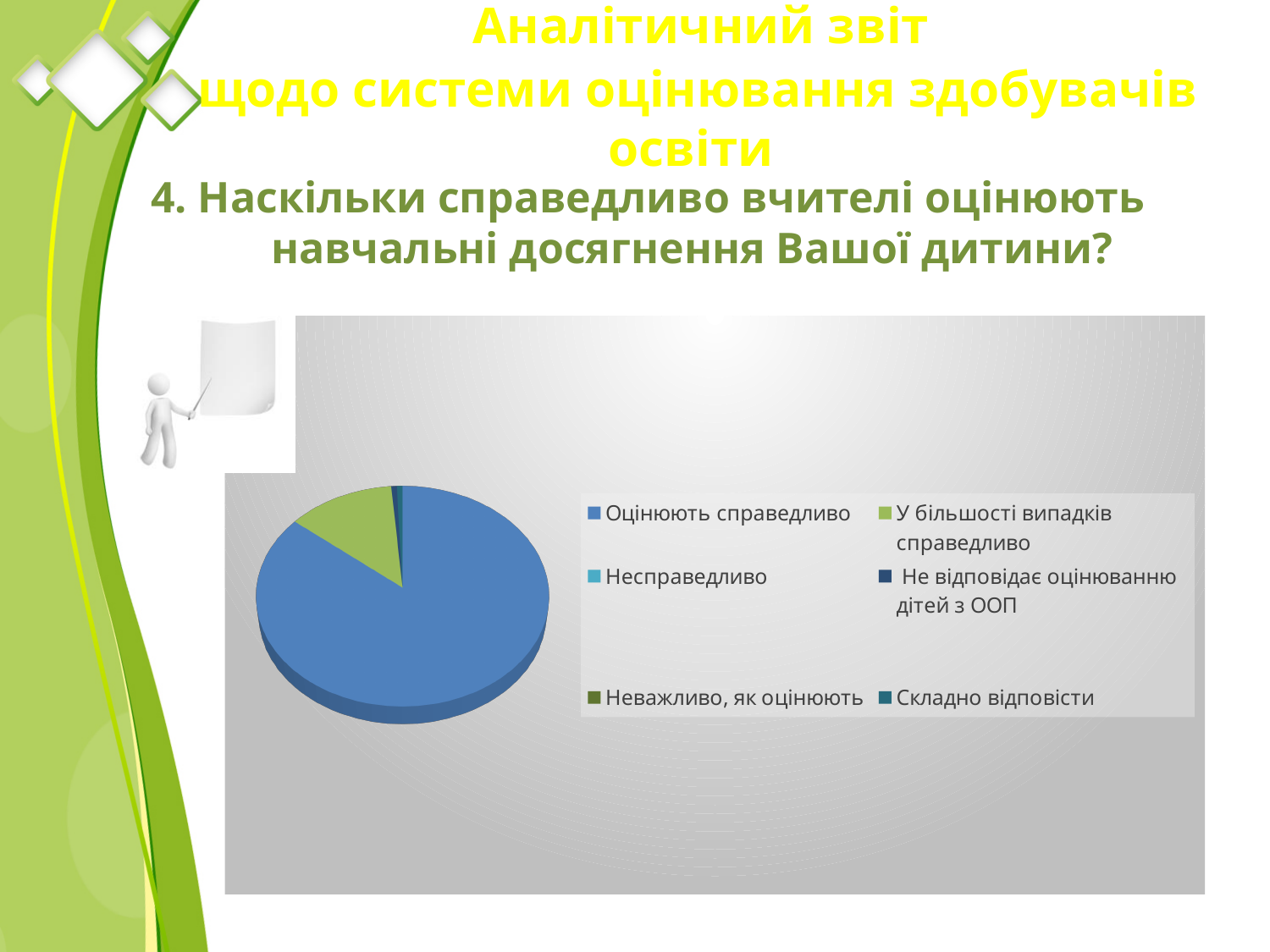
How many categories does the chart legend list? 6 Which slice is larger: "У більшості випадків справедливо" or "Не відповідає оцінюванню дітей з ООП"? У більшості випадків справедливо Which category is shown in green in the legend? У більшості випадків справедливо Which slice is larger: "Оцінюють справедливо" or "У більшості випадків справедливо"? Оцінюють справедливо What kind of chart is shown on the slide? pie chart Which category is the last entry in the chart legend? Складно відповісти Which category has the largest slice of the pie? Оцінюють справедливо